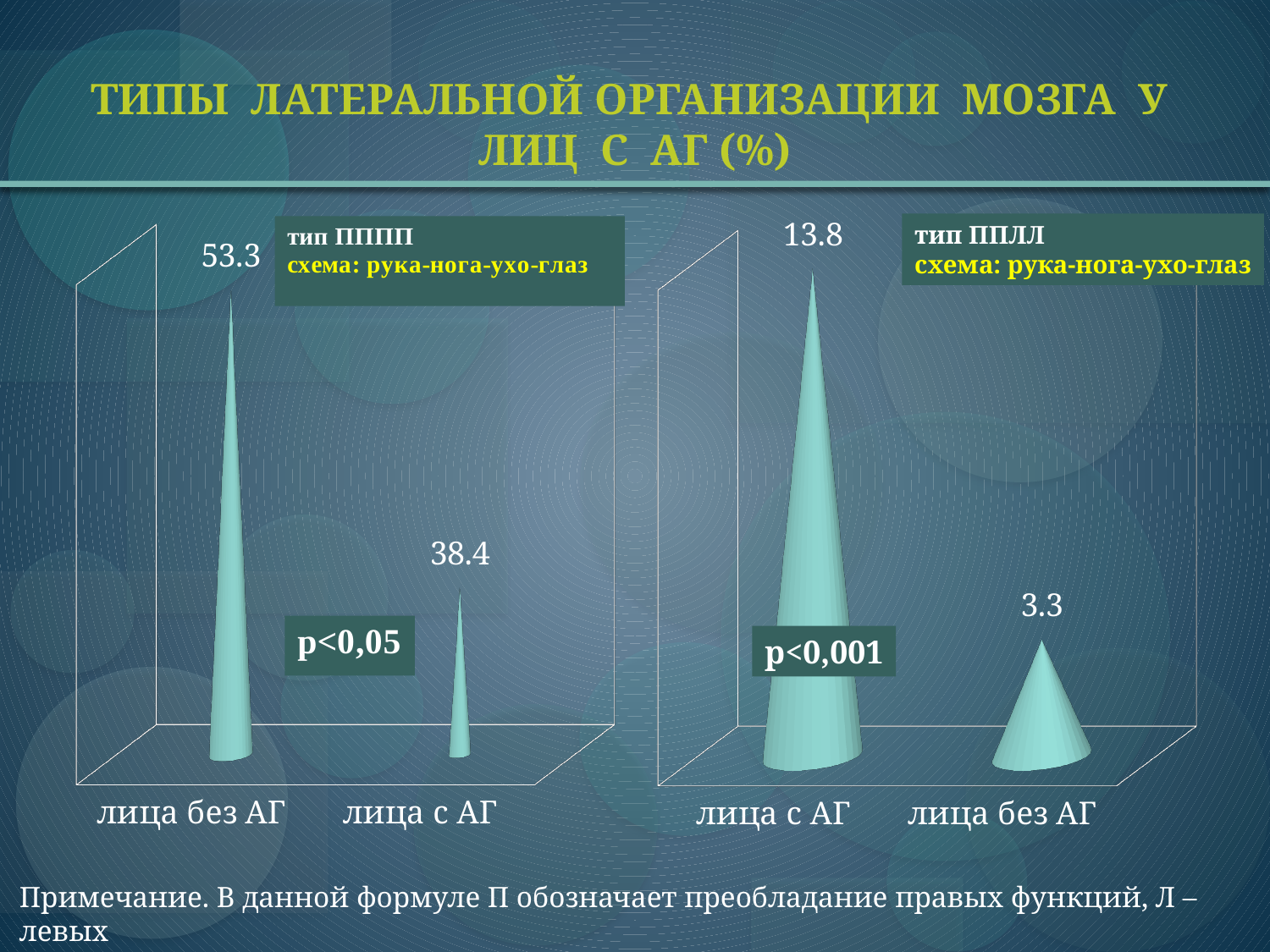
On the left chart (тип ПППП), what is the value for лица с АГ? 38.4 How many categories are shown on the left chart (тип ПППП)? 2 On the right chart (тип ППЛЛ), which is larger: the value for лица с АГ or for лица без АГ? лица с АГ On the right chart (тип ППЛЛ), which category has the lower value? лица без АГ On the right chart (тип ППЛЛ), what is the value for лица с АГ? 13.8 On the left chart (тип ПППП), what is the difference between the values for лица без АГ and лица с АГ? 14.9 On the left chart (тип ПППП), which category has the higher value? лица без АГ On the left chart (тип ПППП), what is the value for лица без АГ? 53.3 What p-value is shown on the right chart (тип ППЛЛ)? p<0,001 What kind of chart is used on the slide? bar chart On the right chart (тип ППЛЛ), what is the value for лица без АГ? 3.3 On the right chart (тип ППЛЛ), what is the difference between the values for лица с АГ and лица без АГ? 10.5